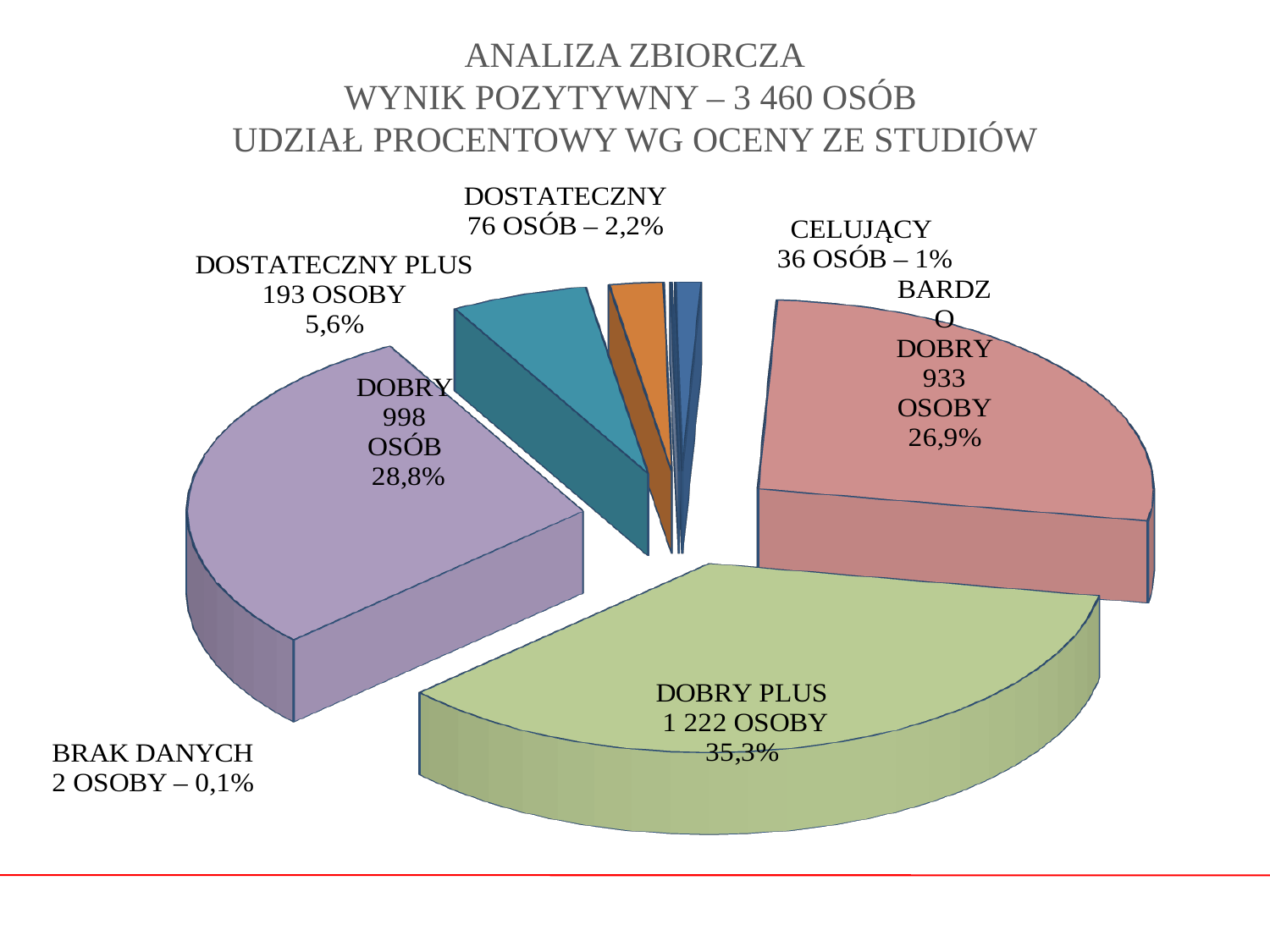
Which category has the smallest share of the pie? BRAK DANYCH Which category has more people: DOBRY or BARDZO DOBRY? DOBRY What type of chart is shown on the slide? pie chart What percentage share does the DOBRY PLUS slice have? 35,3% What percentage is shown for the DOSTATECZNY PLUS category? 5,6% According to the chart title, how many people in total had a positive result? 3 460 Which category has the largest share of the pie? DOBRY PLUS How many categories (slices) does the pie chart show? 7 What is the difference in the number of people between DOBRY PLUS and DOBRY? 224 What is the difference in percentage points between DOSTATECZNY PLUS and DOSTATECZNY? 3,4 How many people are in the BARDZO DOBRY category? 933 How many people are in the CELUJĄCY category? 36